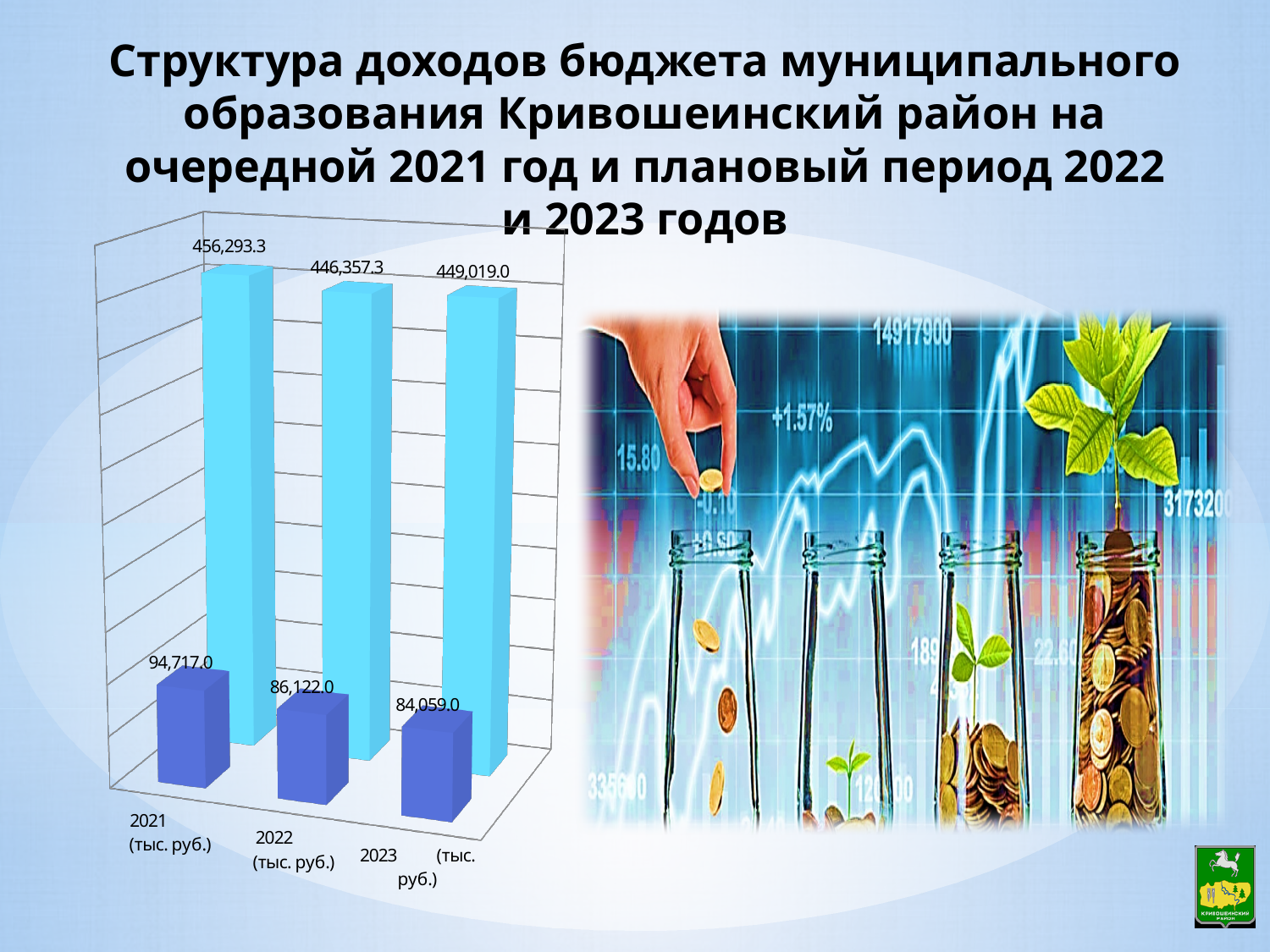
What is the value of the dark blue bar for 2022? 86,122.0 What is the value of the light blue bar for 2022? 446,357.3 What is the value of the dark blue bar for 2023? 84,059.0 How many years are shown on the x axis of the chart? 3 In which year is the light blue bar the lowest? 2022 What is the difference between the light blue bar values for 2021 and 2022? 9,936.0 What kind of chart is shown on the slide? Bar chart In which year is the dark blue bar the highest? 2021 What is the difference between the dark blue bar values for 2021 and 2022? 8,595.0 What is the value of the light blue bar for 2021? 456,293.3 Which is larger: the light blue bar for 2023 or the light blue bar for 2022? 2023 Do the dark blue bar values rise or fall from 2021 to 2023? Fall